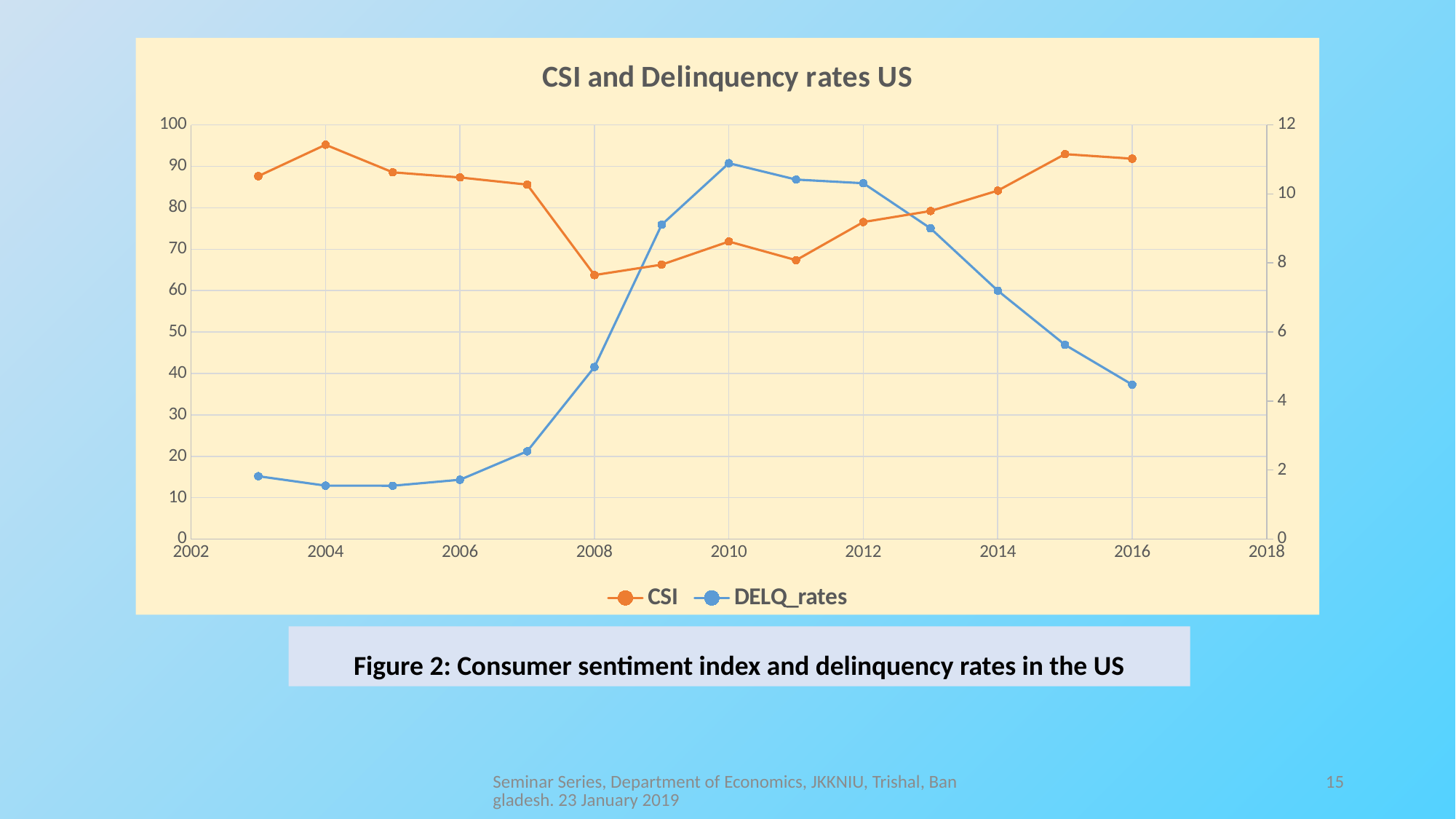
What is the title of the chart? CSI and Delinquency rates US What kind of chart is shown on the slide? Line chart Is the CSI value for 2008 greater or less than 70? less Which is larger, the CSI value for 2004 or the CSI value for 2008? 2004 How many data points does the CSI series have? 14 Is the DELQ_rates value for 2003 greater or less than 2 on the right-hand axis? less Is the CSI value for 2004 greater or less than 90? greater Do the DELQ_rates values rise or fall from 2010 to 2016? Fall What colour is the DELQ_rates line? Blue How many series does the legend list? 2 Which year has the highest CSI value? 2004